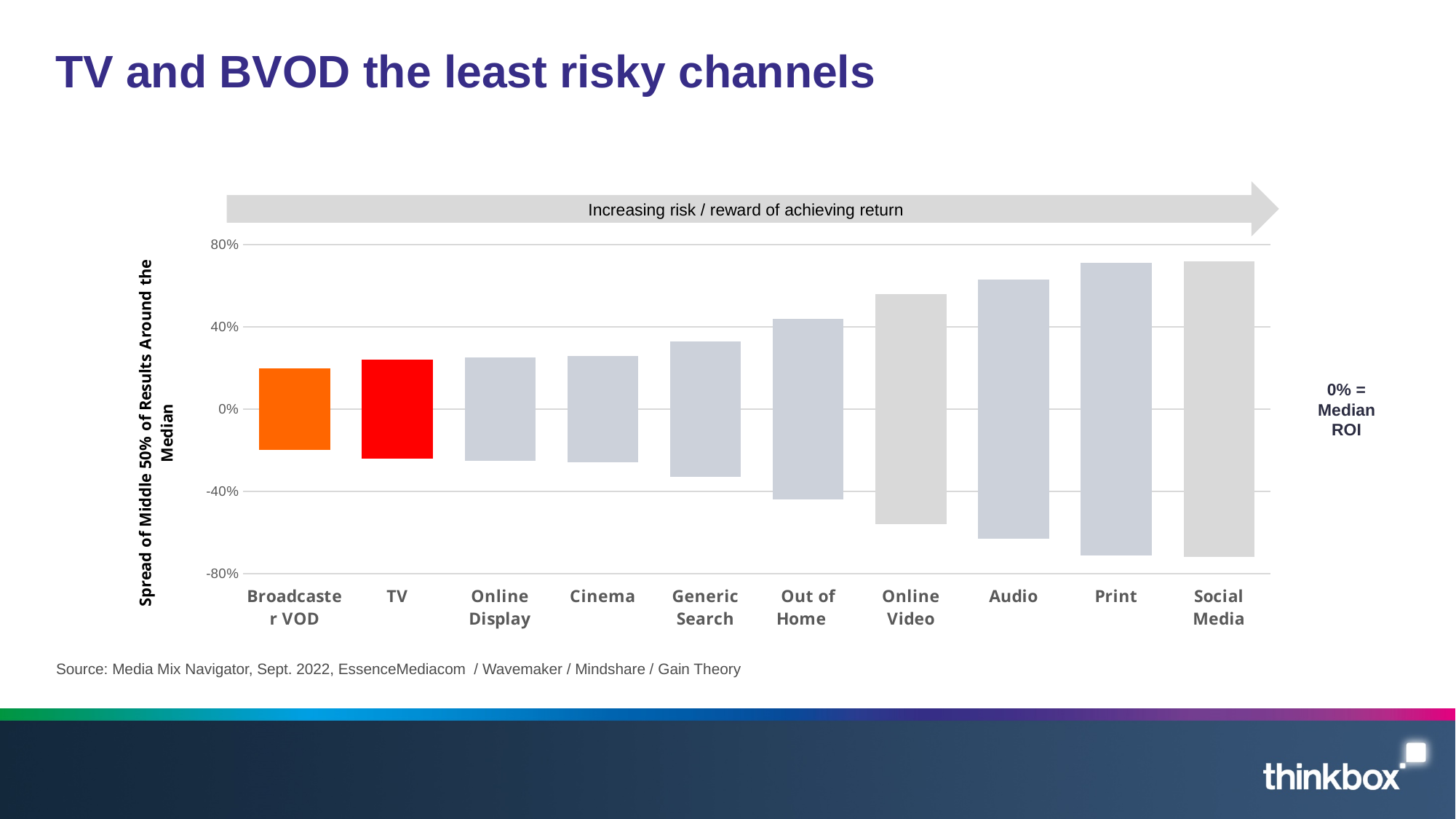
Which channel has a wider spread of results, Print or Online Display? Print Is the upper end of the Online Video bar greater or less than 40%? greater What does the arrow above the chart say? Increasing risk / reward of achieving return Is the upper end of the Broadcaster VOD bar greater or less than 40%? less Does the spread of results rise or fall moving from left to right along the x axis? rise Is the lower end of the Cinema bar greater or less than -40%? greater Which channel has the widest spread of results around the median? Social Media Which channel has the narrowest spread of results around the median? Broadcaster VOD What kind of chart is shown on the slide? bar chart How many channels are shown along the x axis of the chart? 10